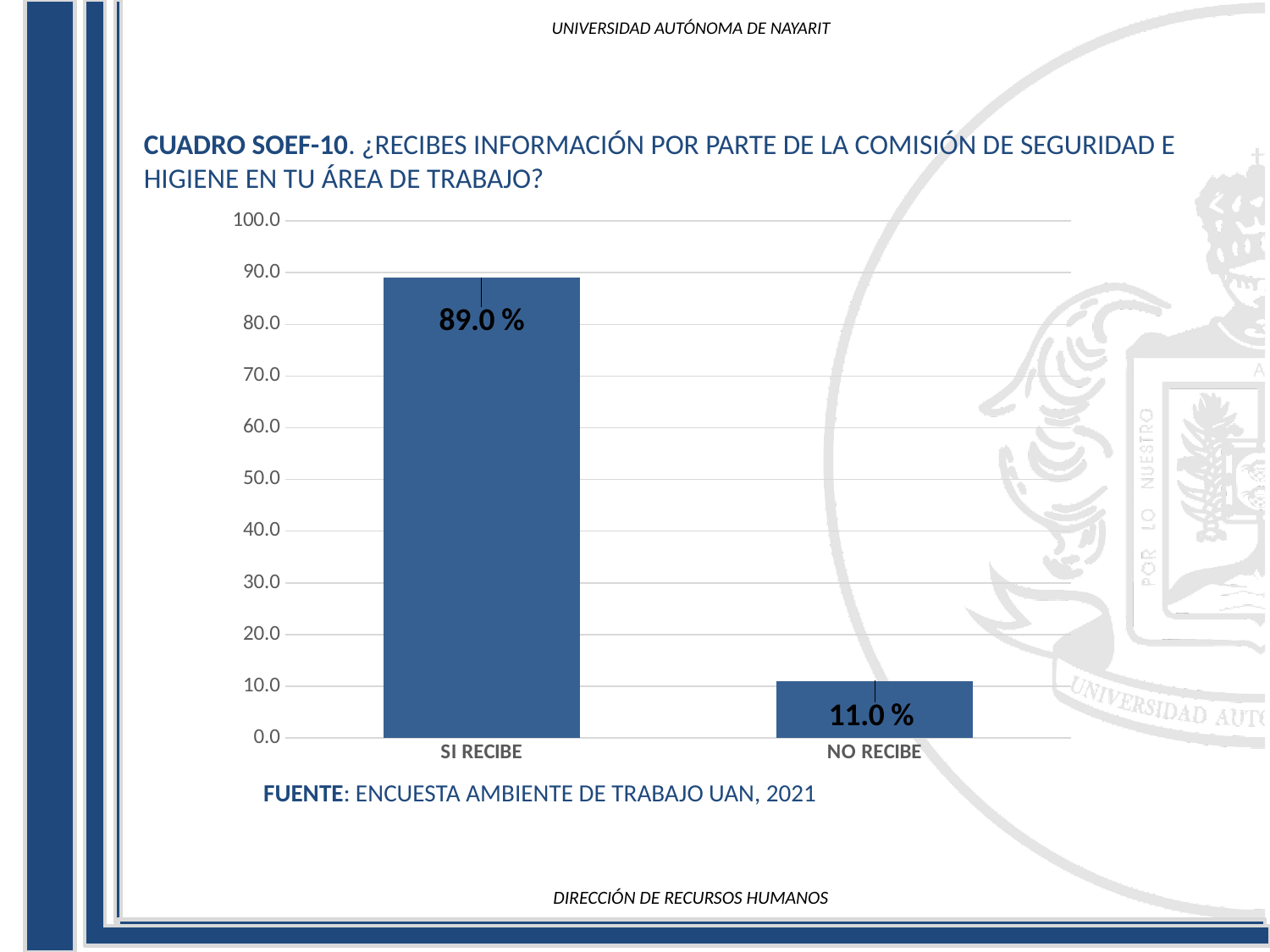
Is the value for SI RECIBE greater or less than 80.0? greater What kind of chart is shown on the slide? Bar chart What is the value for SI RECIBE? 89.0 % What is the source cited below the chart? ENCUESTA AMBIENTE DE TRABAJO UAN, 2021 What is the maximum value shown on the y axis? 100.0 Which is larger, the value for SI RECIBE or the value for NO RECIBE? SI RECIBE What is the value for NO RECIBE? 11.0 % Which category has the highest value? SI RECIBE What is the difference between the values for SI RECIBE and NO RECIBE? 78.0 % Is the value for NO RECIBE greater or less than 20.0? less Which category has the lowest value? NO RECIBE How many categories are shown on the x axis? 2